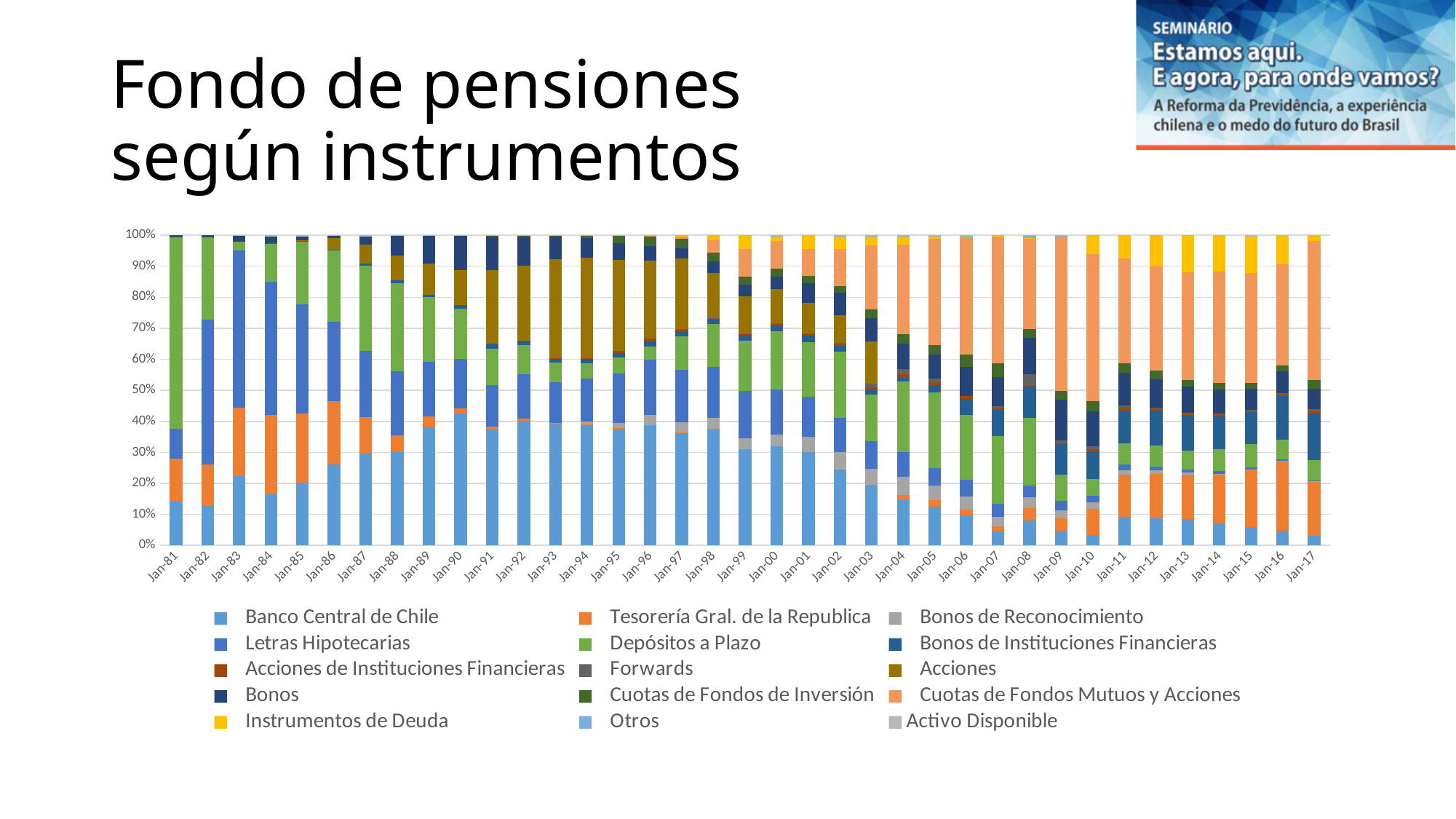
Does the share of Banco Central de Chile rise or fall from Jan-90 to Jan-17? fall Which series is listed first in the legend? Banco Central de Chile Is the share of Banco Central de Chile in Jan-17 greater or less than 10%? less Is the share of Letras Hipotecarias in Jan-83 greater or less than 40%? greater Is the share of Banco Central de Chile in Jan-81 greater or less than 20%? less Does the share of Cuotas de Fondos Mutuos y Acciones rise or fall from Jan-99 to Jan-17? rise What is the title of the slide containing the chart? Fondo de pensiones según instrumentos What kind of chart is shown on the slide? bar chart What is the total of the stacked bar for Jan-17? 100% How many series does the legend list? 15 How many dates (bars) are plotted along the x axis, from Jan-81 to Jan-17? 37